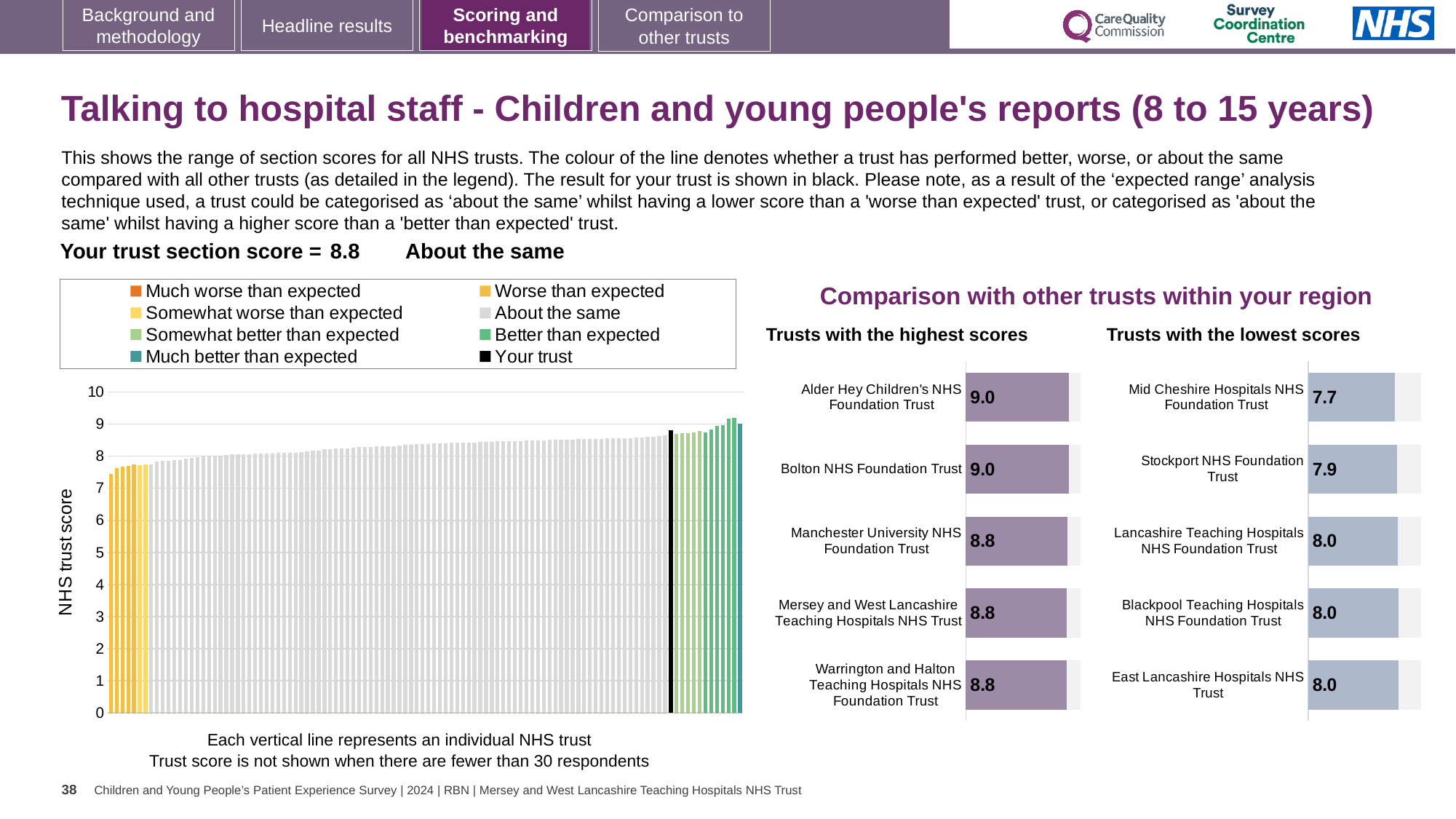
In the large chart on the left, is the value of the rightmost (highest) bar greater or less than 8? greater How many trusts are shown in the 'Trusts with the highest scores' chart? 5 In the 'Trusts with the highest scores' chart, what is the score for Manchester University NHS Foundation Trust? 8.8 In the large chart on the left, do the bar values rise or fall from left to right along the x axis? Rise In the 'Trusts with the lowest scores' chart, which has the larger score: Mid Cheshire Hospitals NHS Foundation Trust or Blackpool Teaching Hospitals NHS Foundation Trust? Blackpool Teaching Hospitals NHS Foundation Trust How many entries does the legend above the large chart on the left list? 8 In the 'Trusts with the lowest scores' chart, which trust has the lowest score? Mid Cheshire Hospitals NHS Foundation Trust What kind of chart is the large chart on the left with the y-axis labelled 'NHS trust score'? Bar chart In the 'Trusts with the lowest scores' chart, what is the score for Stockport NHS Foundation Trust? 7.9 In the large chart on the left, is the value of the leftmost (lowest) bar greater or less than 8? less In the 'Trusts with the highest scores' chart, what is the score for Alder Hey Children's NHS Foundation Trust? 9.0 In the 'Trusts with the highest scores' chart, what is the difference between the scores of Bolton NHS Foundation Trust and Warrington and Halton Teaching Hospitals NHS Foundation Trust? 0.2